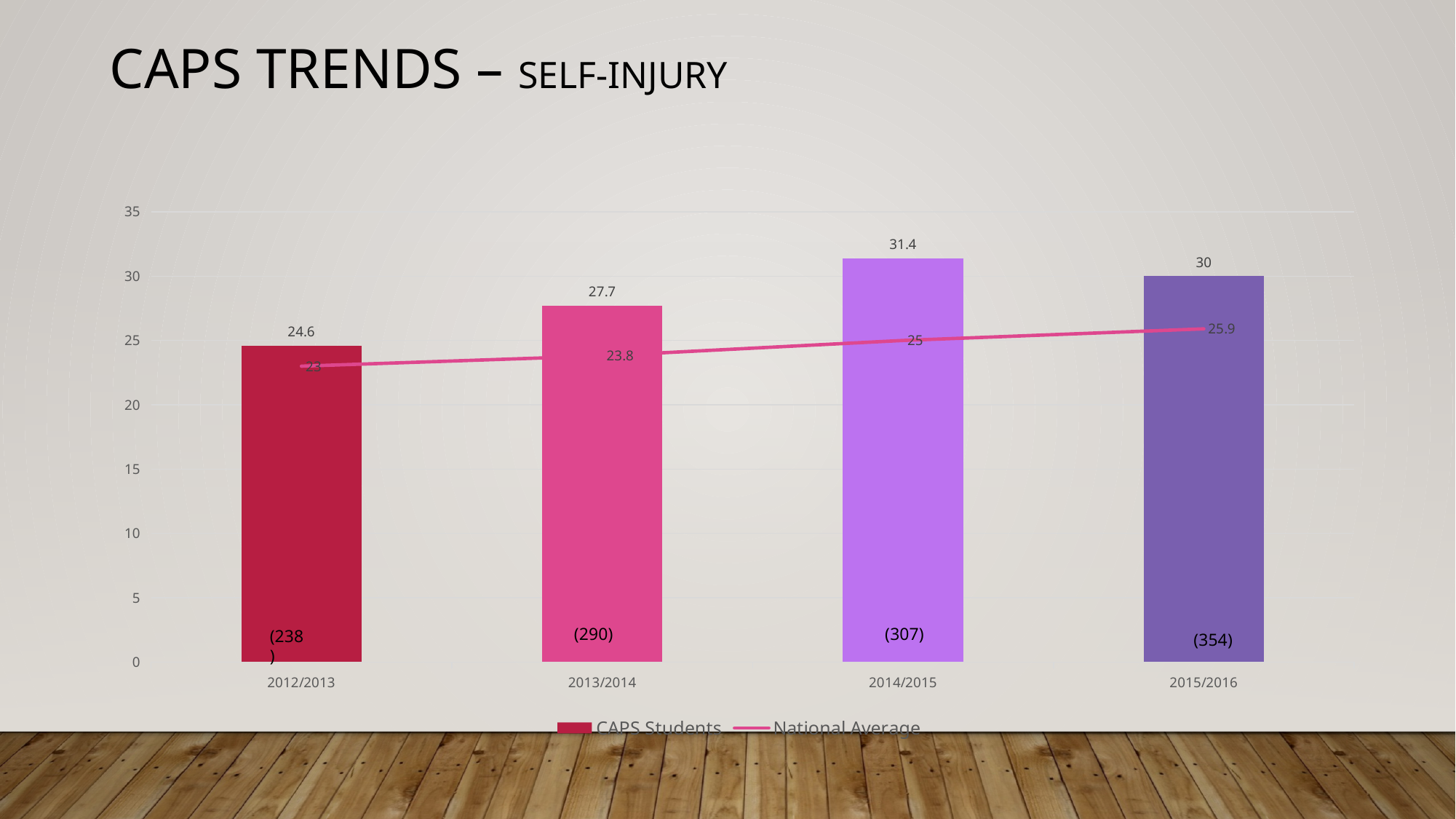
Which year has the lowest CAPS Students value? 2012/2013 What is the CAPS Students value for 2014/2015? 31.4 What number is printed inside the 2015/2016 bar? (354) What is the CAPS Students value for 2015/2016? 30 What is the National Average value for 2013/2014? 23.8 What kind of chart is used for the CAPS Students series? Bar chart Which year has the highest CAPS Students value? 2014/2015 How many years are shown on the x axis? 4 How many series does the legend list? 2 Which is larger in 2012/2013, the CAPS Students value or the National Average? CAPS Students Does the National Average rise or fall from 2012/2013 to 2015/2016? Rise What is the difference between the CAPS Students value and the National Average in 2014/2015? 6.4